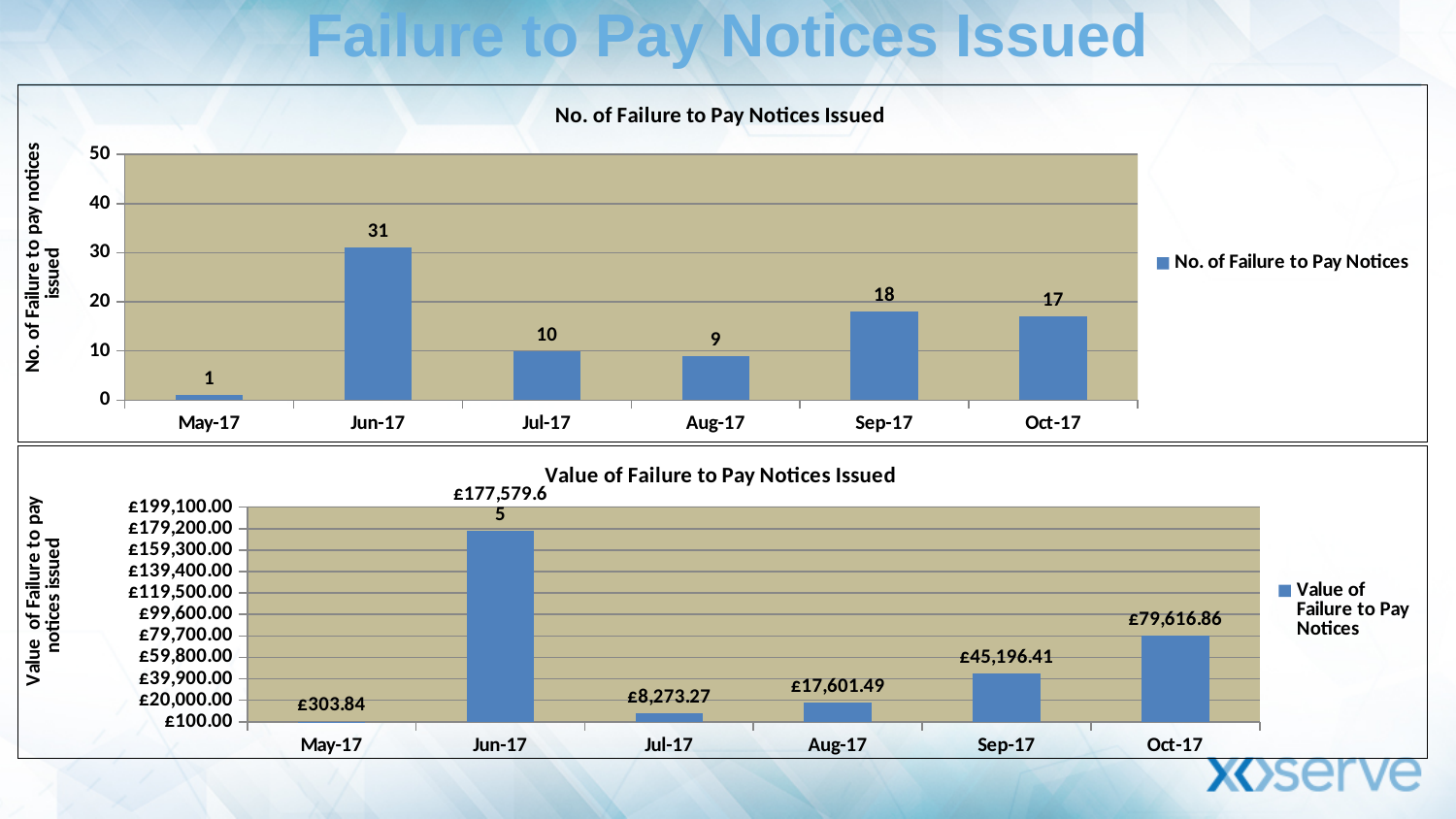
In the 'No. of Failure to Pay Notices Issued' chart, what is the difference between the Jun-17 and Jul-17 values? 21 In the 'No. of Failure to Pay Notices Issued' chart, how many months are shown on the x axis? 6 In the 'Value of Failure to Pay Notices Issued' chart, is the value for Jun-17 greater or less than £159,300.00? greater In the 'Value of Failure to Pay Notices Issued' chart, what is the value for May-17? £303.84 In the 'No. of Failure to Pay Notices Issued' chart, how many notices were issued in Jun-17? 31 What type of chart is the 'No. of Failure to Pay Notices Issued' chart? Bar chart In the 'Value of Failure to Pay Notices Issued' chart, what is the value for Oct-17? £79,616.86 In the 'No. of Failure to Pay Notices Issued' chart, which month has the highest number of notices? Jun-17 How many series does the legend of the 'Value of Failure to Pay Notices Issued' chart list? 1 In the 'Value of Failure to Pay Notices Issued' chart, which is larger, the value for Aug-17 or the value for Sep-17? Sep-17 In the 'No. of Failure to Pay Notices Issued' chart, which month has the lowest number of notices? May-17 In the 'No. of Failure to Pay Notices Issued' chart, how many notices were issued in Sep-17? 18